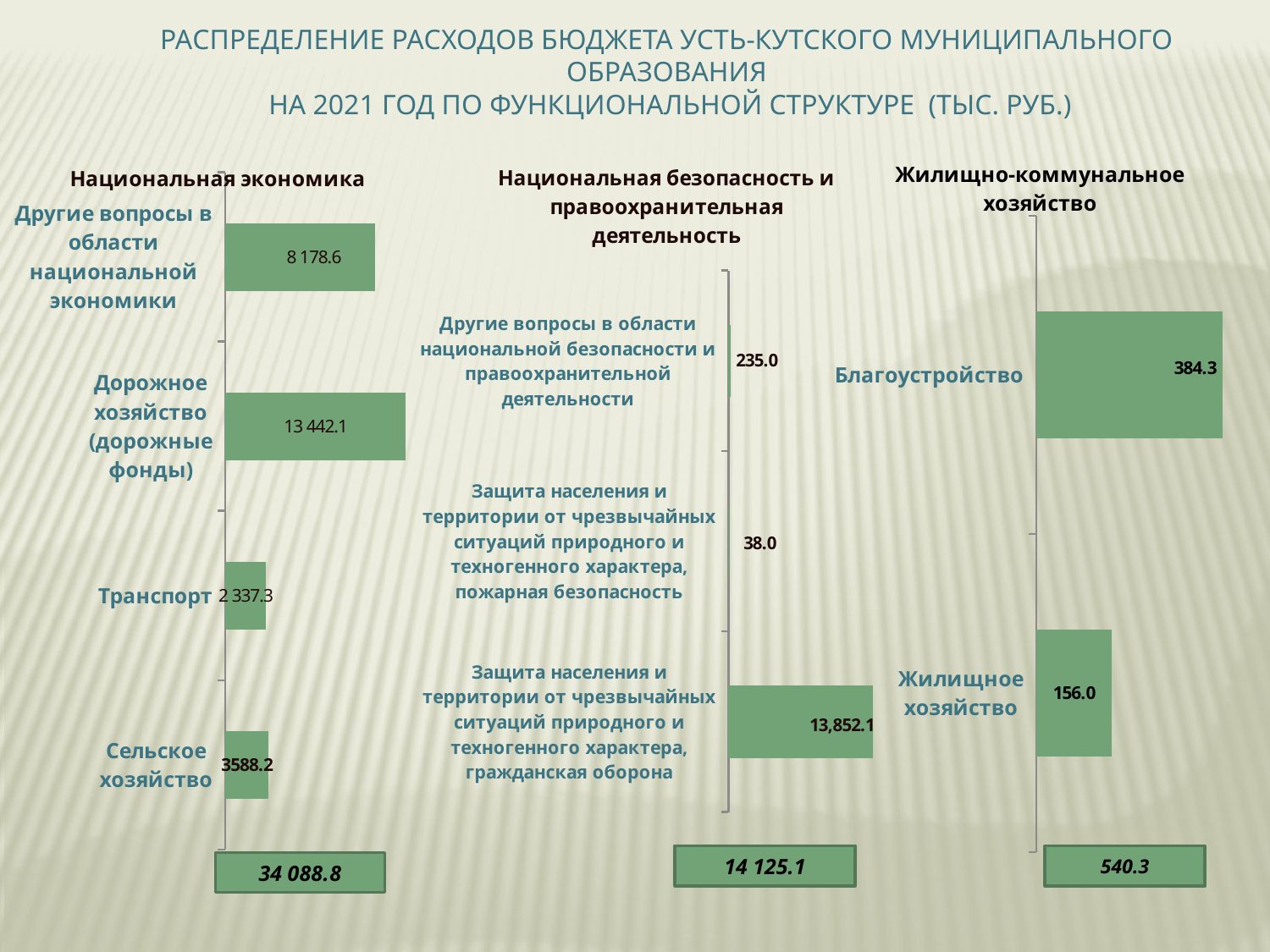
In the 'Национальная экономика' chart, which category has the highest value? Дорожное хозяйство (дорожные фонды) In the 'Национальная безопасность и правоохранительная деятельность' chart, what is the difference between the value for 'Другие вопросы в области национальной безопасности и правоохранительной деятельности' and the value for 'Защита населения и территории от чрезвычайных ситуаций природного и техногенного характера, пожарная безопасность'? 197.0 In the 'Национальная экономика' chart, what is the value for 'Сельское хозяйство'? 3588.2 In the 'Национальная безопасность и правоохранительная деятельность' chart, what is the value for 'Защита населения и территории от чрезвычайных ситуаций природного и техногенного характера, гражданская оборона'? 13,852.1 In the 'Национальная безопасность и правоохранительная деятельность' chart, which category has the lowest value? Защита населения и территории от чрезвычайных ситуаций природного и техногенного характера, пожарная безопасность In the 'Жилищно-коммунальное хозяйство' chart, what is the difference between 'Благоустройство' and 'Жилищное хозяйство'? 228.3 In the 'Жилищно-коммунальное хозяйство' chart, which is larger: 'Благоустройство' or 'Жилищное хозяйство'? Благоустройство In the 'Национальная экономика' chart, how many categories are shown? 4 What kind of chart is the 'Жилищно-коммунальное хозяйство' chart? Bar chart In the 'Жилищно-коммунальное хозяйство' chart, what is the value for 'Благоустройство'? 384.3 In the 'Национальная экономика' chart, what is the value for 'Дорожное хозяйство (дорожные фонды)'? 13 442.1 In the 'Национальная экономика' chart, which category has the lowest value? Транспорт